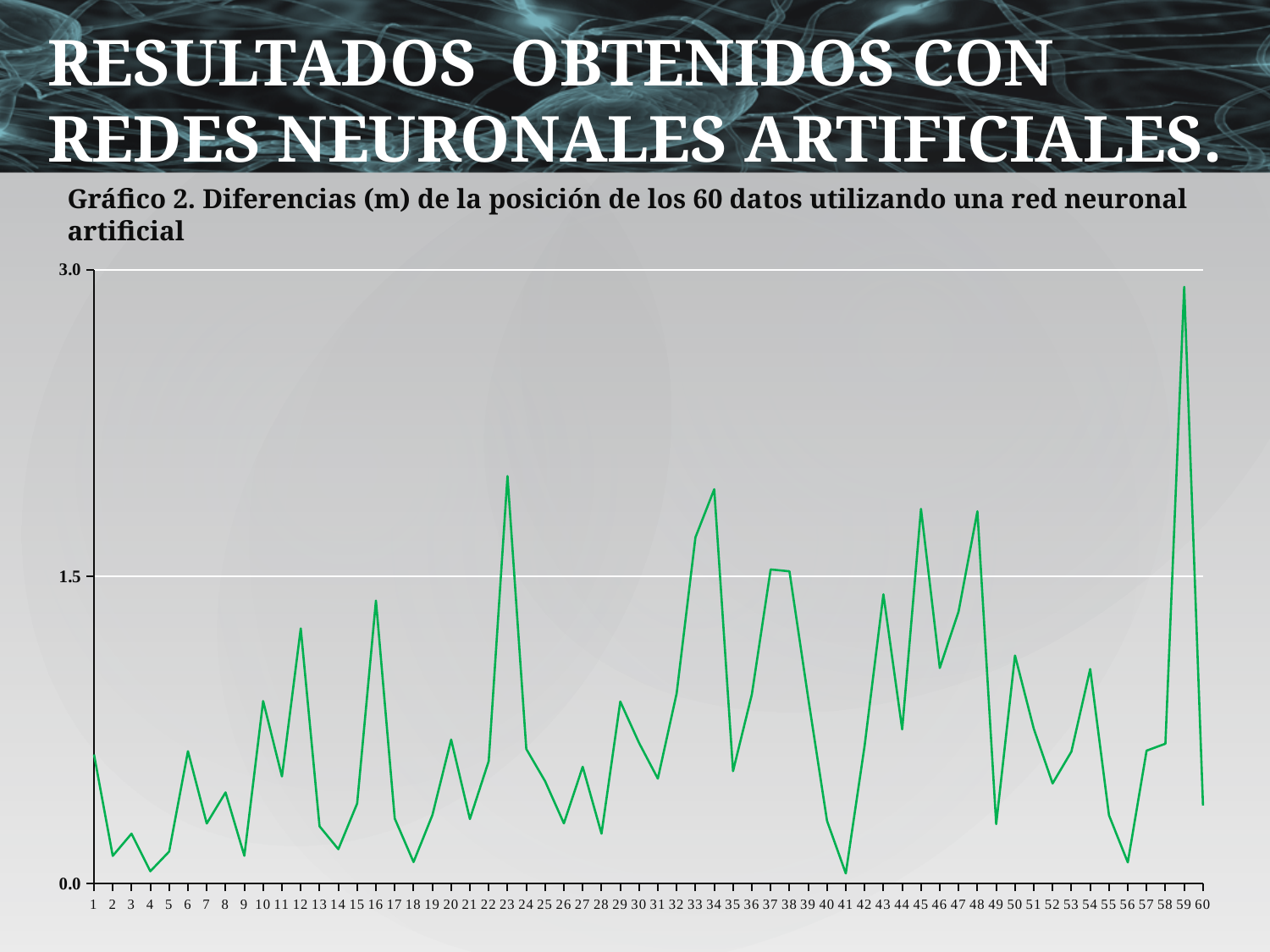
What kind of chart is shown on the slide? line chart What is the title of the chart? Gráfico 2. Diferencias (m) de la posición de los 60 datos utilizando una red neuronal artificial Is the value for data point 34 greater or less than 1.5? greater Which is larger, the value for data point 2 or the value for data point 23? 23 Is the value for data point 23 greater or less than 1.5? greater What is the highest value shown on the y axis? 3.0 Is the value for data point 59 greater or less than 1.5? greater How many data points are plotted along the x axis? 60 Which is larger, the value for data point 59 or the value for data point 60? 59 Which data point has the highest value? 59